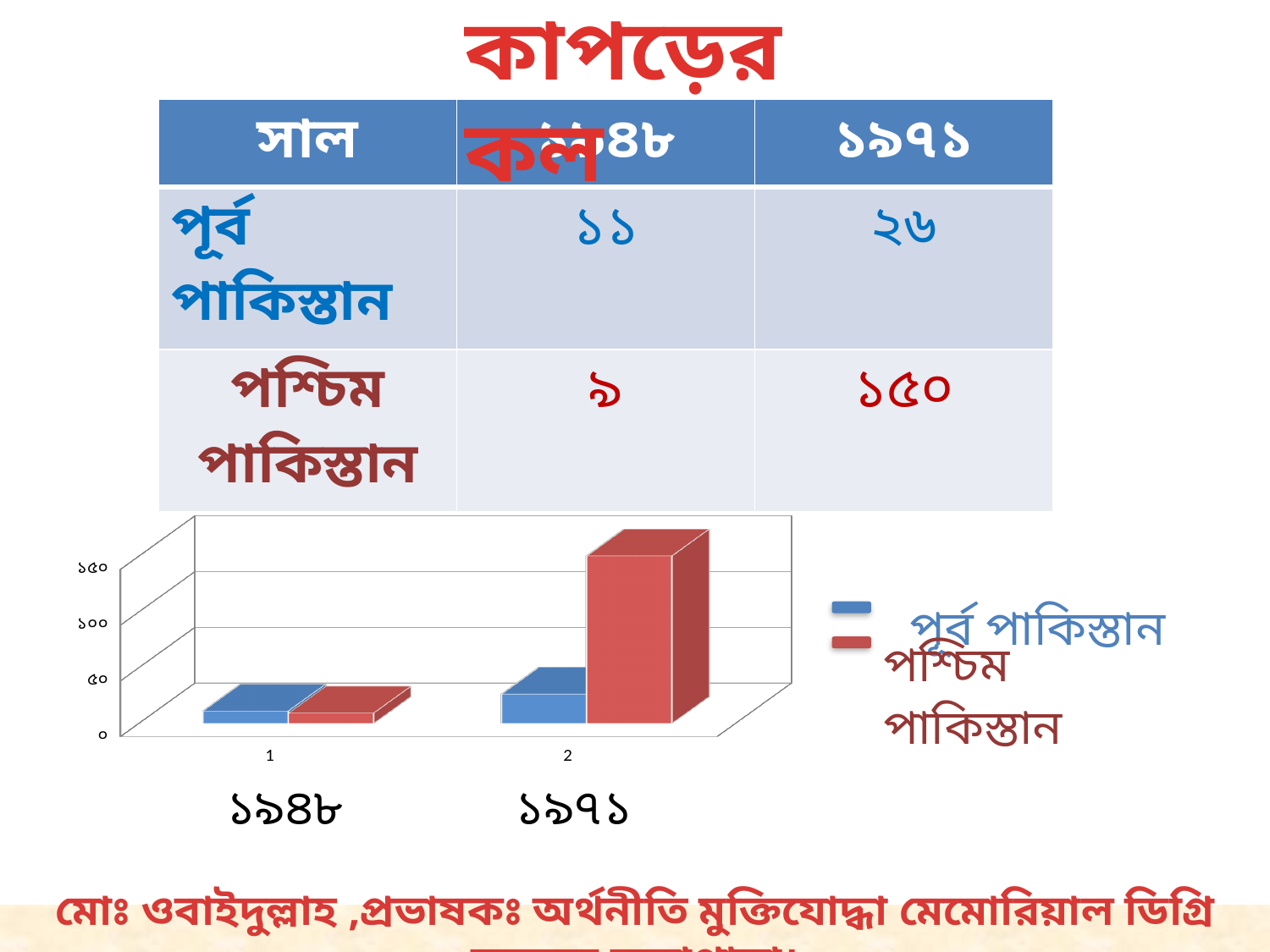
How many series does the chart's legend list? 2 Using the values in the table, what is the difference between পশ্চিম পাকিস্তান and পূর্ব পাকিস্তান in ১৯৭১? ১২৪ In ১৯৭১, which is larger: the bar for পূর্ব পাকিস্তান or the bar for পশ্চিম পাকিস্তান? পশ্চিম পাকিস্তান How many categories (years) are plotted on the x axis of the chart? 2 Is the value for পশ্চিম পাকিস্তান in ১৯৭১ greater or less than ১০০? greater Which bar is the tallest in the chart? পশ্চিম পাকিস্তান in ১৯৭১ Is the value for পূর্ব পাকিস্তান in ১৯৭১ greater or less than ৫০? less Does the value for পশ্চিম পাকিস্তান rise or fall from ১৯৪৮ to ১৯৭১? rise What kind of chart is shown on the slide? bar chart According to the table on the slide, what is the value for পূর্ব পাকিস্তান in ১৯৭১? ২৬ Which series is shown in blue in the chart? পূর্ব পাকিস্তান According to the table on the slide, what is the value for পশ্চিম পাকিস্তান in ১৯৪৮? ৯